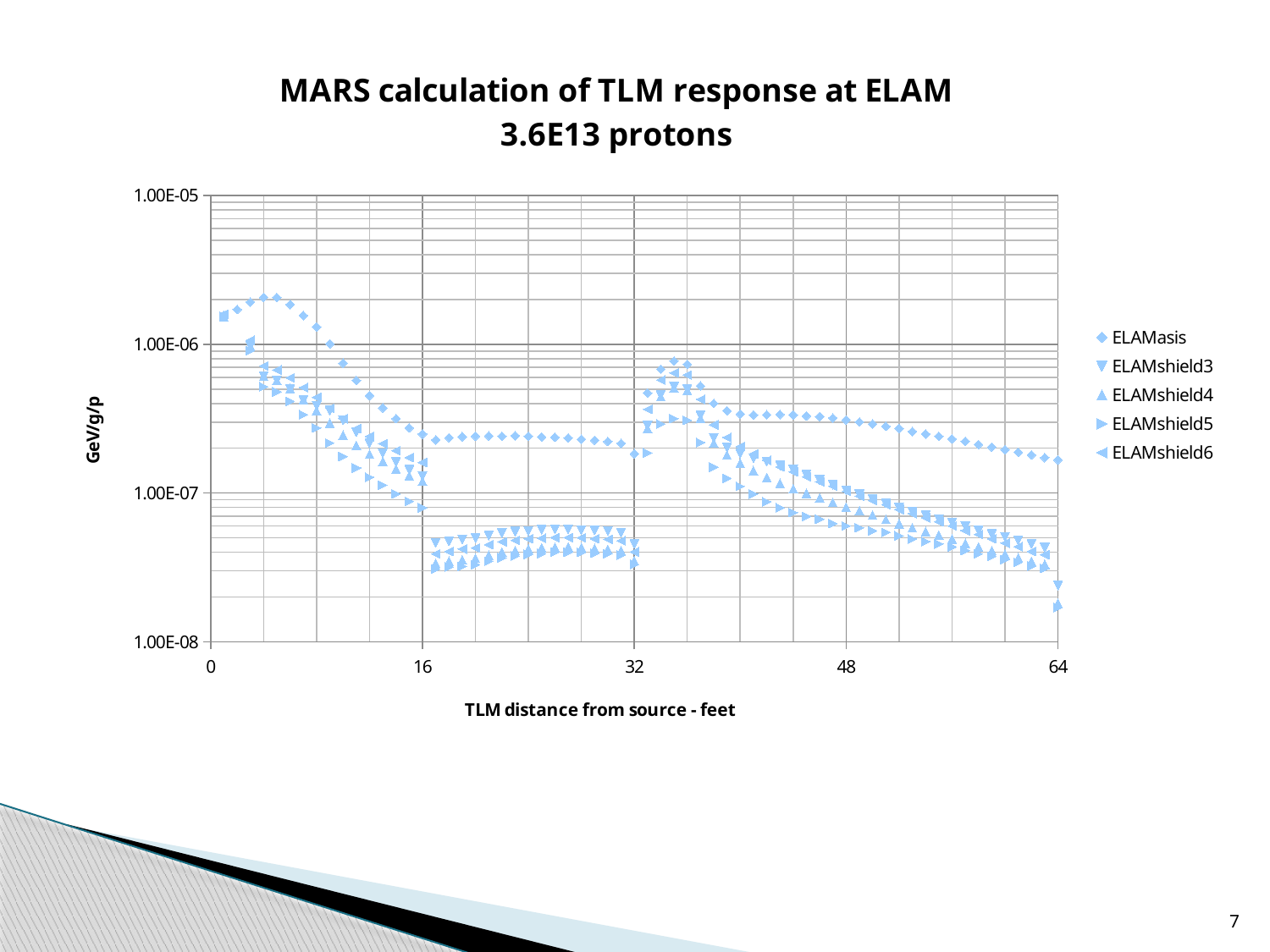
What kind of chart is shown on the slide? scatter chart What is the label of the x axis? TLM distance from source - feet What is the title of the chart? MARS calculation of TLM response at ELAM 3.6E13 protons Is the peak value of ELAMasis near 4 feet greater or less than 1.00E-06? greater Which series has the highest values at 64 feet? ELAMasis How many labelled tick marks are on the x axis? 5 Is the value for ELAMshield3 at 32 feet greater or less than 1.00E-07? less Do the ELAMasis values rise or fall between 48 and 64 feet? fall How many series does the legend list? 5 Is the value for ELAMasis at 64 feet greater or less than 1.00E-07? greater At 48 feet, which is larger: ELAMasis or ELAMshield3? ELAMasis